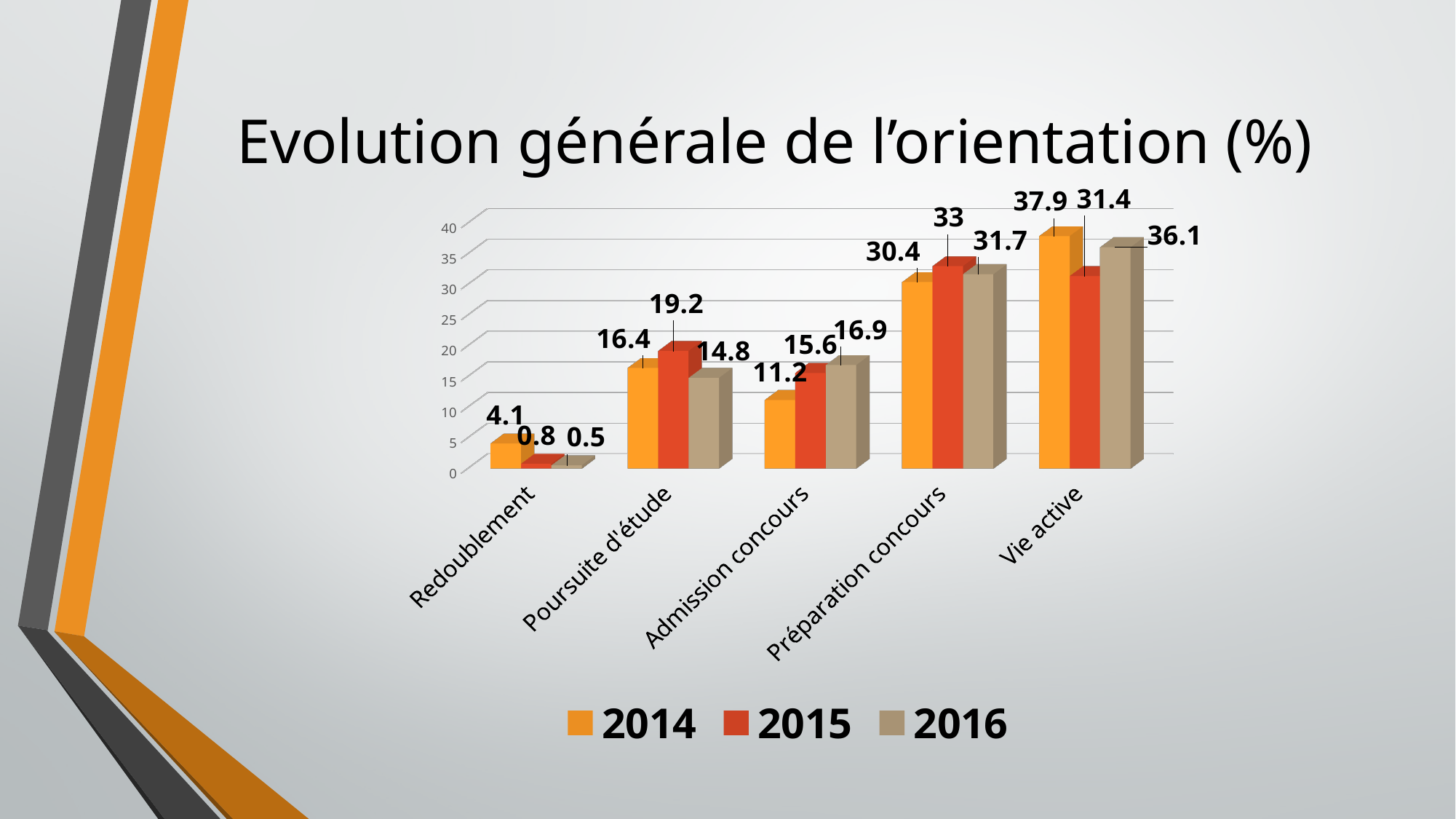
Which category has the highest value in 2015? Préparation concours What is the value for Poursuite d'étude in 2015? 19.2 How many series does the legend list? 3 Which is larger for Préparation concours: the 2014 value or the 2016 value? 2016 Which category has the lowest value in 2014? Redoublement What kind of chart is shown on the slide? Bar chart How many categories are shown on the x axis? 5 What is the value for Vie active in 2014? 37.9 What is the value for Admission concours in 2016? 16.9 What is the difference between the 2014 and 2015 values for Vie active? 6.5 What is the value for Redoublement in 2016? 0.5 What is the title of the chart? Evolution générale de l'orientation (%)